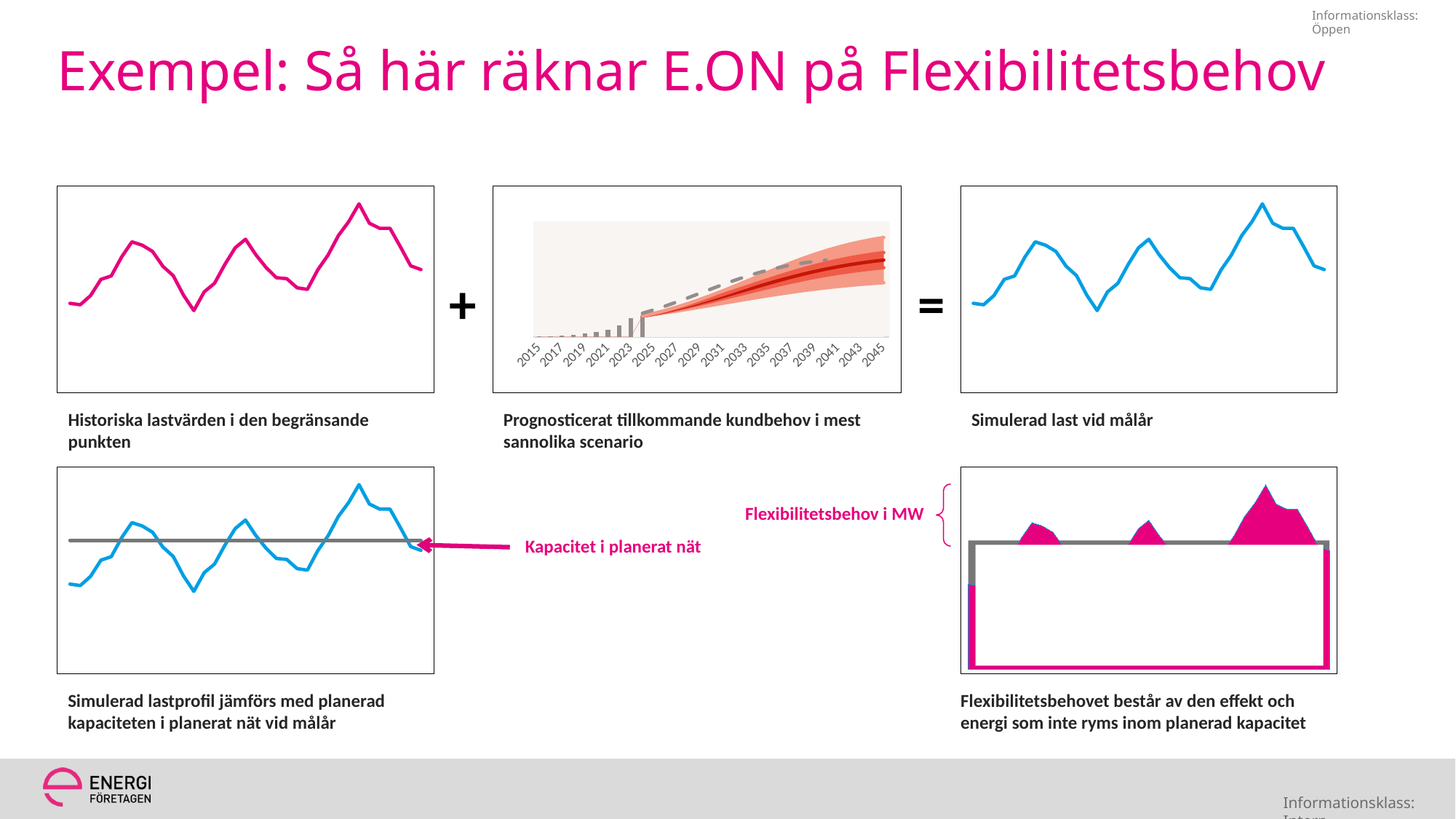
What kind of chart is the top-right chart captioned 'Simulerad last vid målår'? line chart How many year labels are shown on the x axis of the middle chart captioned 'Prognosticerat tillkommande kundbehov i mest sannolika scenario'? 16 In the bottom-right chart, how many separate pink shaded peaks rise above the grey capacity line? 3 In the middle chart captioned 'Prognosticerat tillkommande kundbehov i mest sannolika scenario', does the red forecast line rise or fall from 2025 to 2045? rise In the middle chart captioned 'Prognosticerat tillkommande kundbehov i mest sannolika scenario', what is the first year label on the x axis? 2015 What kind of chart is the top-left chart captioned 'Historiska lastvärden i den begränsande punkten'? line chart In the bottom-right chart, what do the pink shaded areas above the grey line represent according to the label on the slide? Flexibilitetsbehov i MW In the bottom-left chart, what does the grey horizontal line represent according to the label on the slide? Kapacitet i planerat nät In the middle chart captioned 'Prognosticerat tillkommande kundbehov i mest sannolika scenario', do the grey bars between 2015 and 2023 rise or fall over time? rise In the middle chart captioned 'Prognosticerat tillkommande kundbehov i mest sannolika scenario', what is the last year label on the x axis? 2045